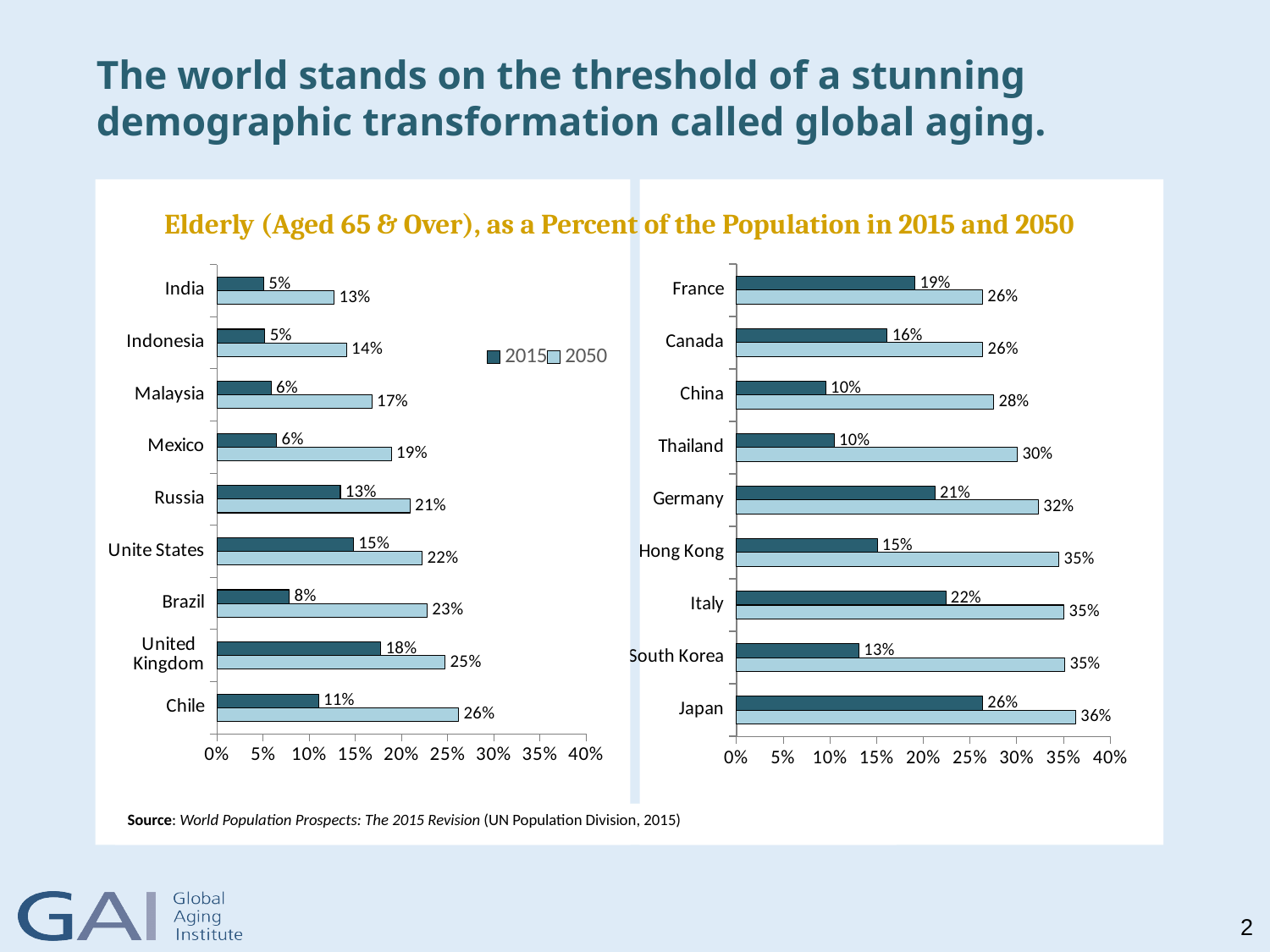
How many countries are shown in the right chart? 9 In the left chart, what is the difference between the 2050 and 2015 values for Mexico? 13% In the right chart, which country has the lowest 2050 value? France and Canada (26%) In the left chart, what is the 2050 value for Brazil? 23% In the left chart, which country has the highest 2050 value? Chile In the right chart, which country has the highest 2015 value? Japan In the right chart, what is the difference between the 2050 and 2015 values for South Korea? 22% In the right chart, what is the 2050 value for Thailand? 30% What type of chart is used on this slide? Bar chart How many series does the legend list? 2 In the left chart, which is larger: the 2015 value for Russia or the 2015 value for Chile? Russia In the right chart, what is the 2015 value for Germany? 21%